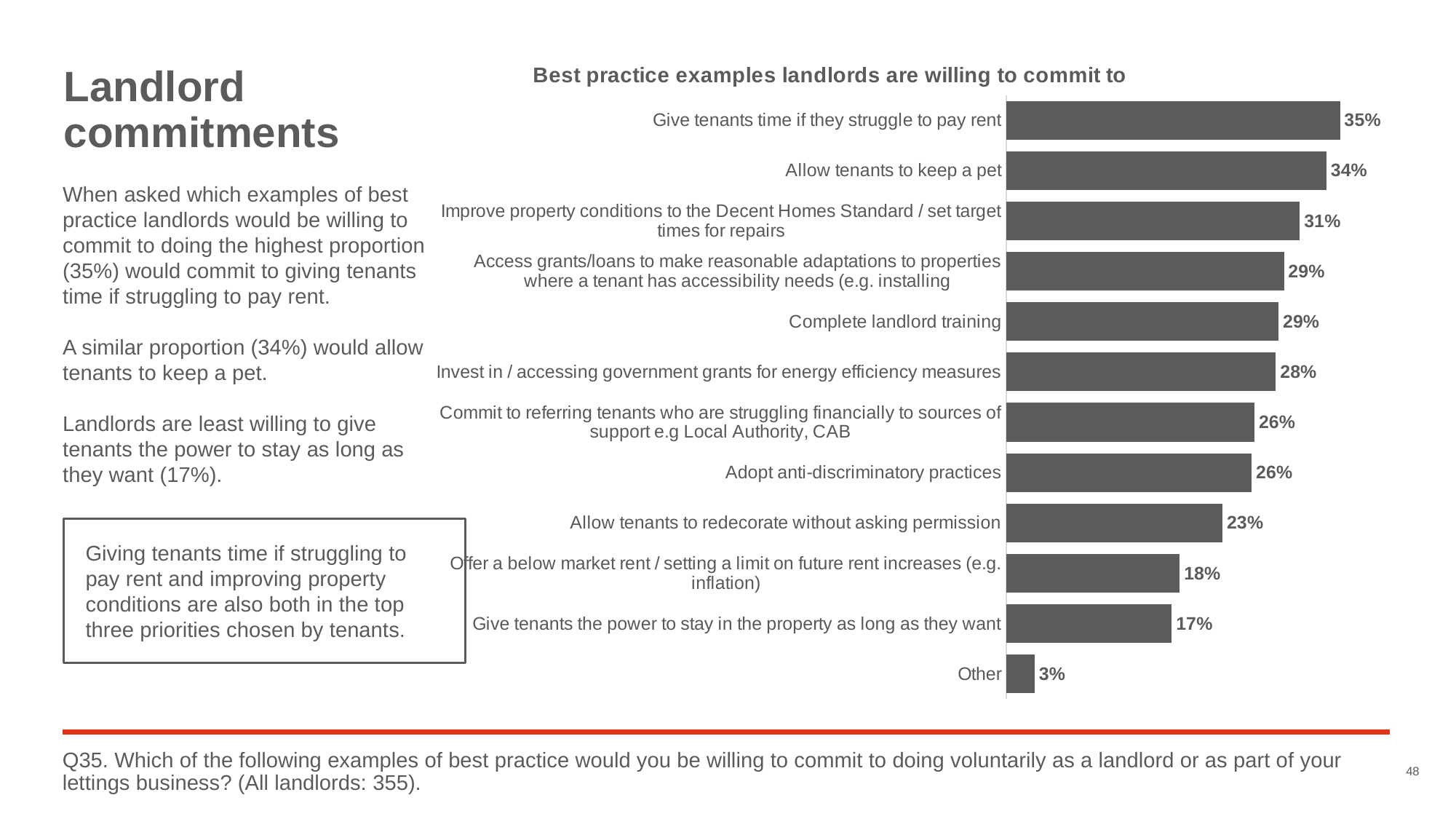
What kind of chart is shown on the slide? Bar chart What percentage of landlords would commit to completing landlord training? 29% What is the difference between the values for 'Allow tenants to keep a pet' and 'Improve property conditions to the Decent Homes Standard / set target times for repairs'? 3% What percentage of landlords are willing to commit to giving tenants time if they struggle to pay rent? 35% What is the value for 'Allow tenants to redecorate without asking permission'? 23% Which category has the lowest value in the chart? Other How many categories are shown in the chart? 12 What is the value for 'Allow tenants to keep a pet'? 34% Which category has the highest value in the chart? Give tenants time if they struggle to pay rent What is the title of the chart? Best practice examples landlords are willing to commit to What is the difference between the values for 'Give tenants time if they struggle to pay rent' and 'Give tenants the power to stay in the property as long as they want'? 18% Which is larger: the value for 'Adopt anti-discriminatory practices' or the value for 'Allow tenants to redecorate without asking permission'? Adopt anti-discriminatory practices